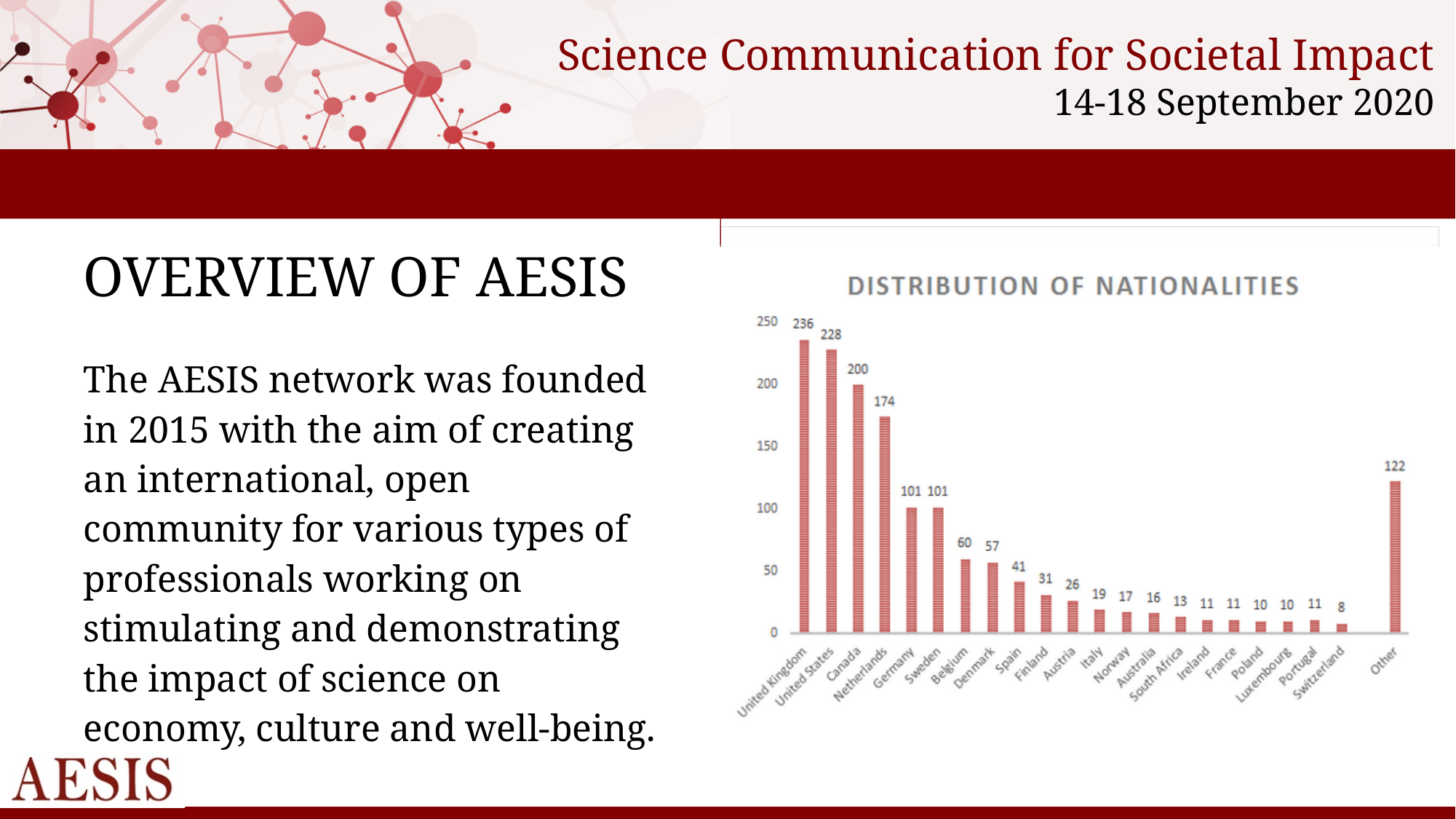
What kind of chart is the Distribution of Nationalities chart? bar chart What is the title of the chart on the slide? Distribution of Nationalities What is the difference between the values for the United States and Canada in the Distribution of Nationalities chart? 28 What is the value for the Netherlands in the Distribution of Nationalities chart? 174 Which category has the lowest value in the Distribution of Nationalities chart? Switzerland What is the value for the United Kingdom in the Distribution of Nationalities chart? 236 Which has a larger value in the Distribution of Nationalities chart, Belgium or Denmark? Belgium What is the value for Spain in the Distribution of Nationalities chart? 41 How many categories are shown on the x axis of the Distribution of Nationalities chart? 22 What is the value for Other in the Distribution of Nationalities chart? 122 Which category has the highest value in the Distribution of Nationalities chart? United Kingdom Is the value for Germany in the Distribution of Nationalities chart greater or less than 150? less